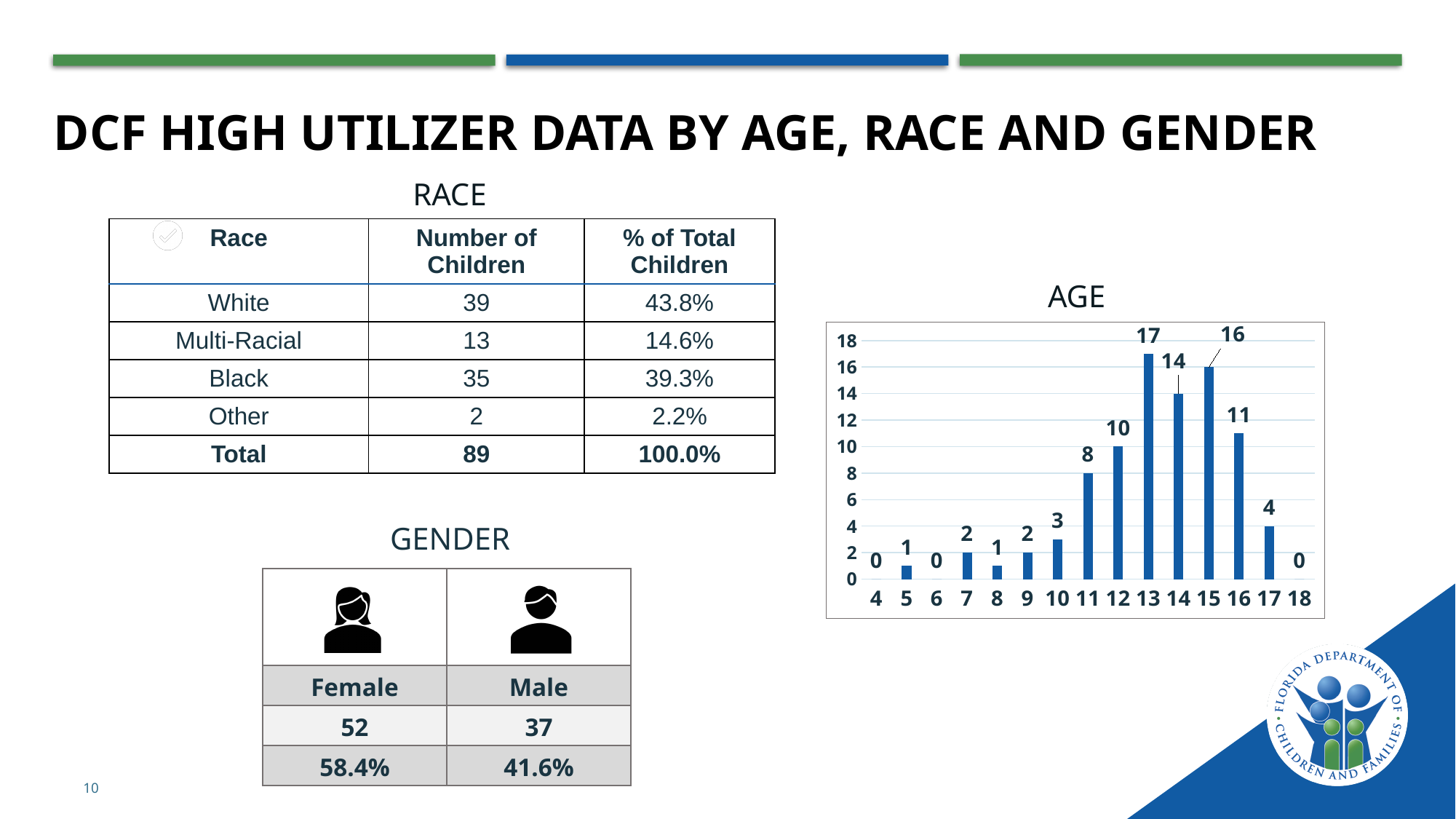
What kind of chart is the AGE chart? bar chart How many age categories are shown on the x axis of the AGE chart? 15 In the AGE chart, what is the difference between the values for age 15 and age 16? 5 In the AGE chart, which age has the highest value? 13 In the AGE chart, do the values rise or fall from age 13 to age 18? fall In the AGE chart, is the value for age 14 greater or less than 12? greater In the AGE chart, what is the value for age 13? 17 In the AGE chart, what is the difference between the values for age 13 and age 14? 3 In the AGE chart, which is larger, the value for age 12 or the value for age 16? age 16 In the AGE chart, what is the value for age 17? 4 What is the title of the chart on the slide? AGE In the AGE chart, what is the value for age 11? 8